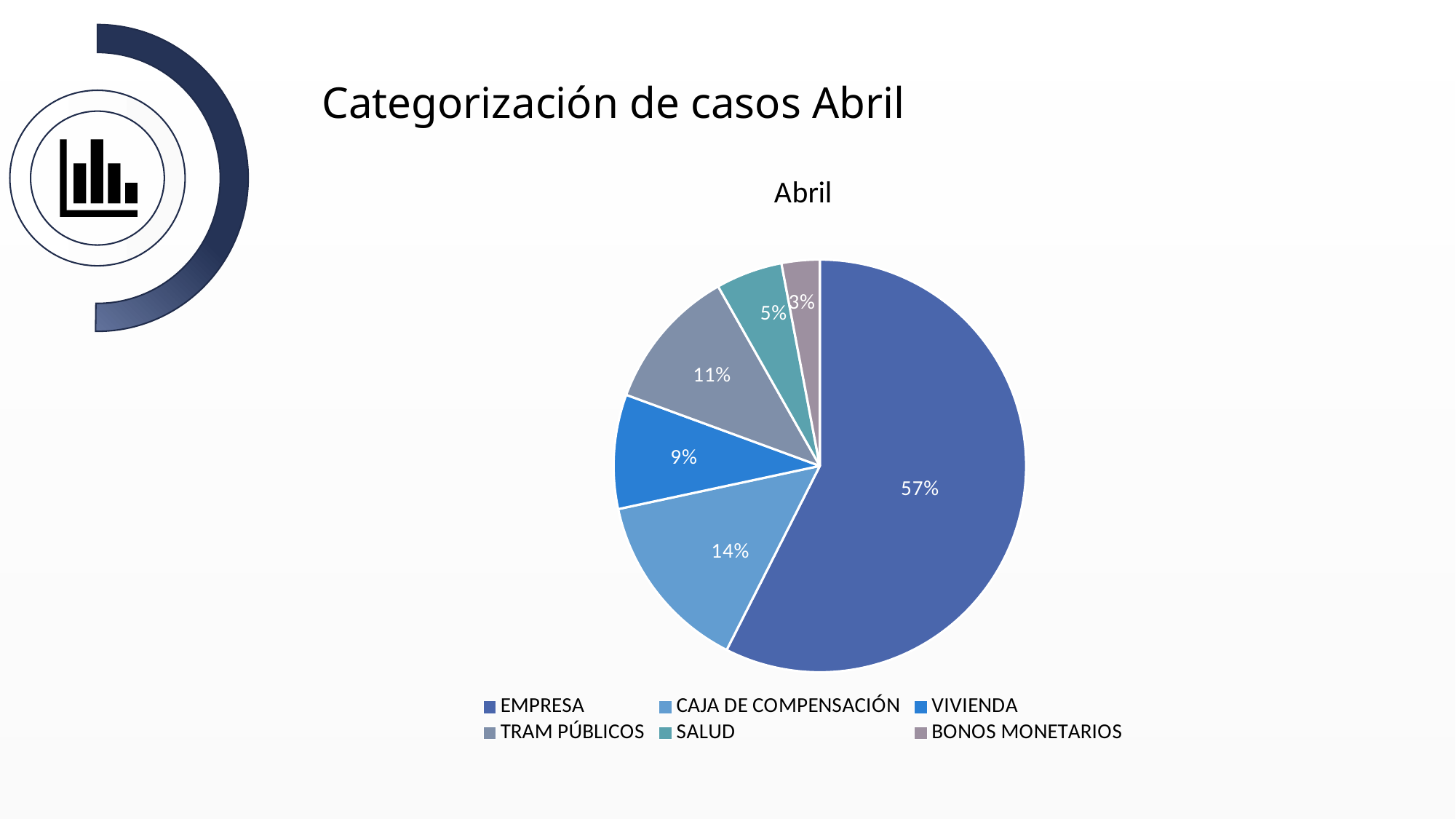
What share of the pie does SALUD have? 5% What share of the pie does BONOS MONETARIOS have? 3% What is the difference between the shares of CAJA DE COMPENSACIÓN and VIVIENDA? 5% Which category has the smallest slice of the pie? BONOS MONETARIOS How many categories does the pie chart show? 6 Which category has the largest slice of the pie? EMPRESA What type of chart is shown on the slide? Pie chart What is the title of the chart? Abril What share of the pie does CAJA DE COMPENSACIÓN have? 14%